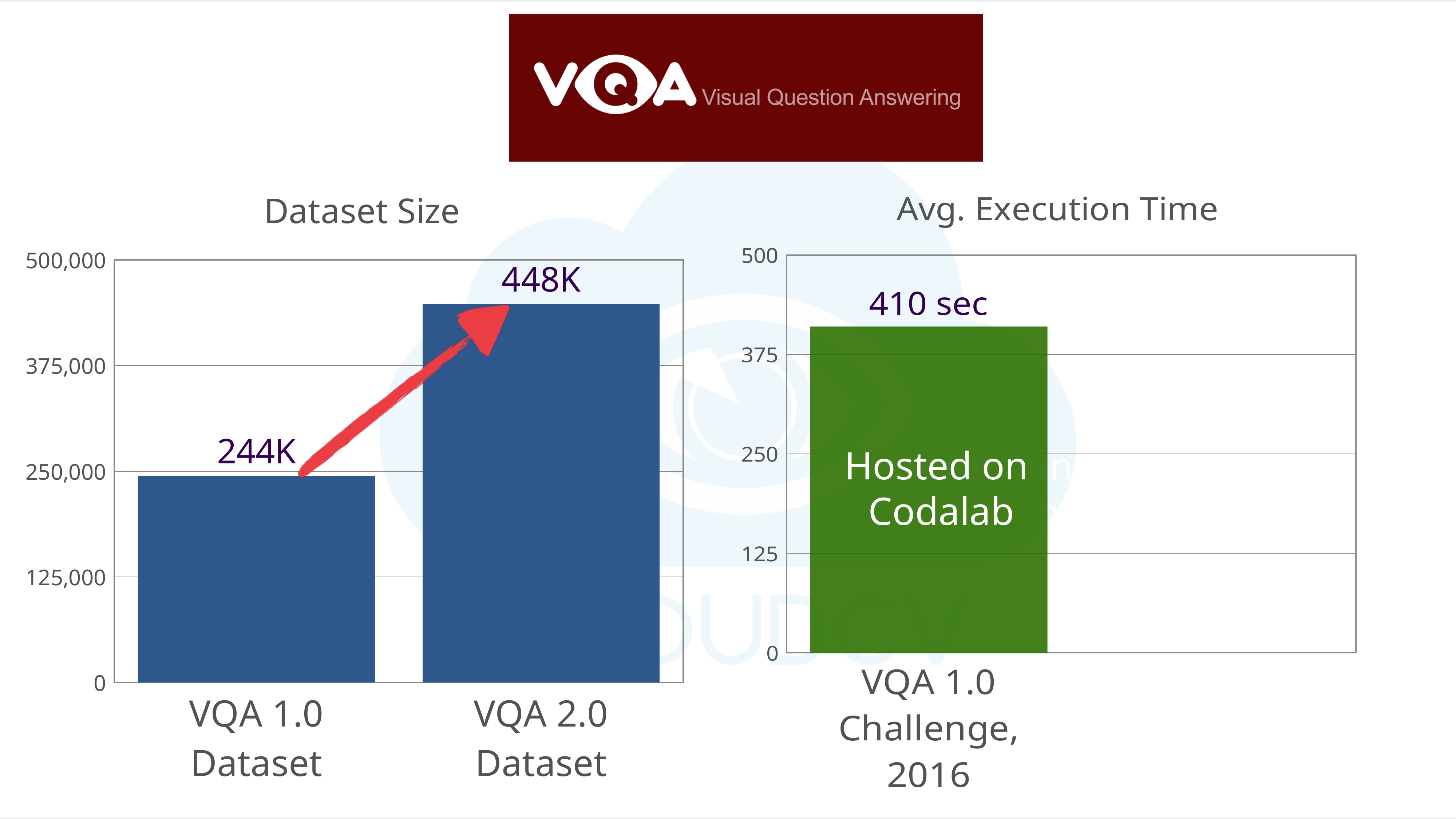
In the Dataset Size chart, what is the value for the VQA 1.0 Dataset? 244K What kind of chart is the Dataset Size chart? bar chart In the Dataset Size chart, which dataset has the smaller size? VQA 1.0 Dataset In the Dataset Size chart, which dataset has the larger size? VQA 2.0 Dataset What text is written inside the bar of the Avg. Execution Time chart? Hosted on Codalab In the Dataset Size chart, what is the value for the VQA 2.0 Dataset? 448K In the Avg. Execution Time chart, is the value for VQA 1.0 Challenge, 2016 greater or less than 375? greater In the Dataset Size chart, is the value for the VQA 1.0 Dataset greater or less than 250,000? less In the Avg. Execution Time chart, what is the value for VQA 1.0 Challenge, 2016? 410 sec How many bars are in the Avg. Execution Time chart? 1 How many bars are in the Dataset Size chart? 2 In the Dataset Size chart, what is the difference between the VQA 2.0 Dataset and the VQA 1.0 Dataset values? 204K